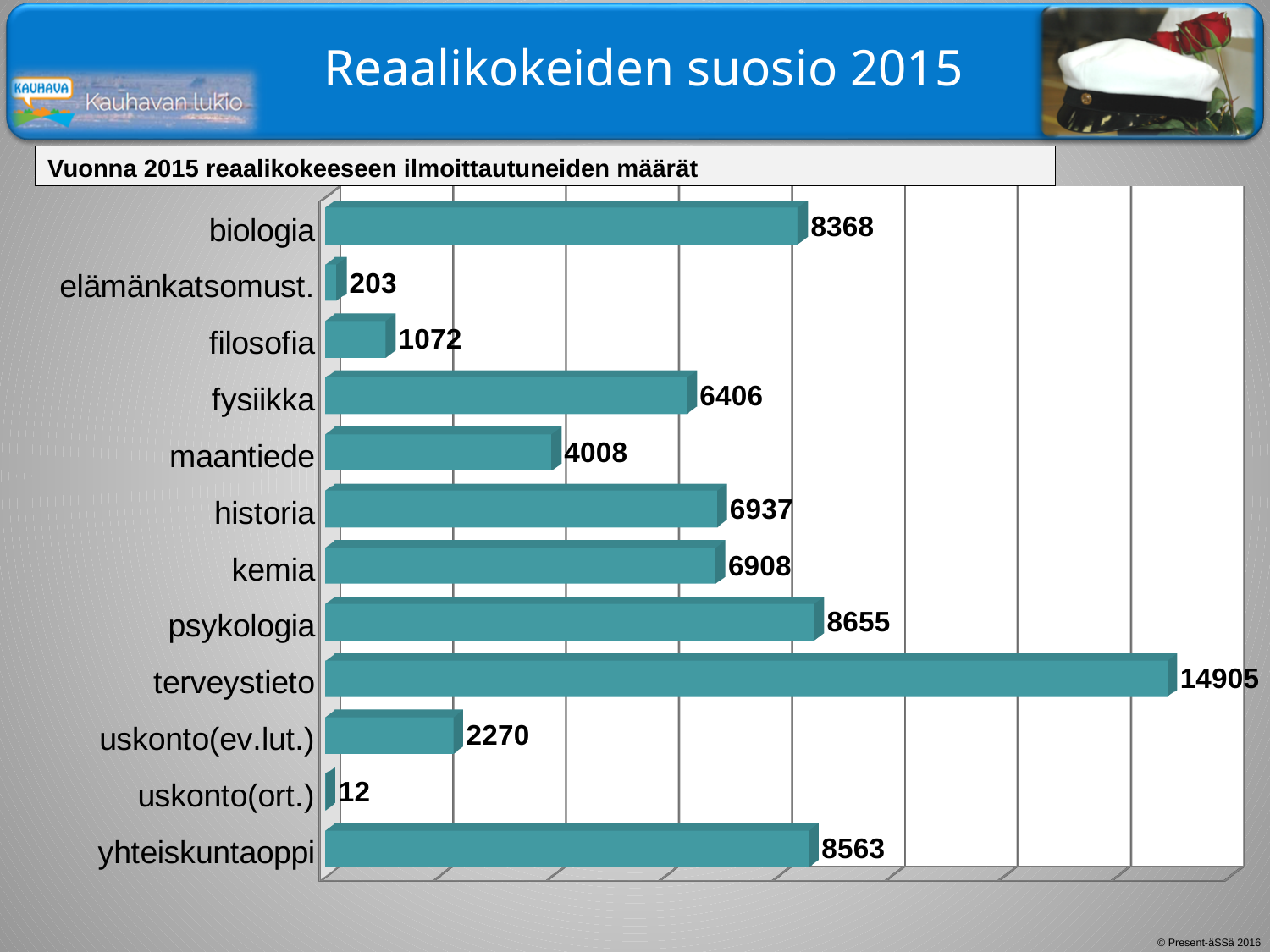
Which is larger, the value for filosofia or the value for elämänkatsomust.? filosofia What kind of chart is shown on the slide? bar chart Which category has the highest value? terveystieto Which is larger, the value for psykologia or the value for yhteiskuntaoppi? psykologia Which category has the lowest value? uskonto(ort.) What is the value for terveystieto? 14905 What is the difference between the values for terveystieto and psykologia? 6250 What is the value for uskonto(ev.lut.)? 2270 How many categories are shown in the chart? 12 What is the difference between the values for biologia and fysiikka? 1962 What is the value for maantiede? 4008 What is the title of the chart? Vuonna 2015 reaalikokeeseen ilmoittautuneiden määrät